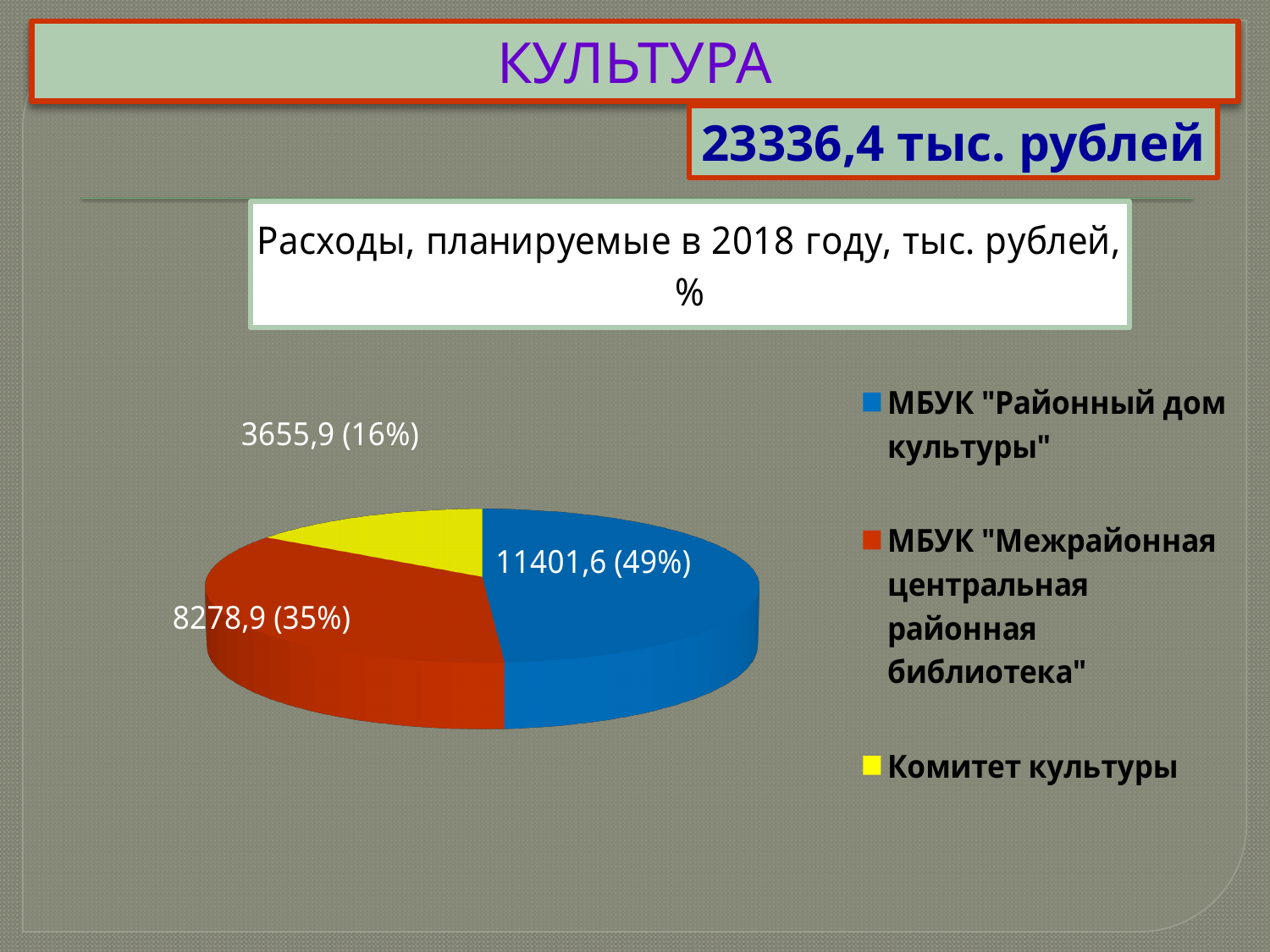
What is the value for Комитет культуры? 3655,9 What is the difference between the value for МБУК "Районный дом культуры" and the value for МБУК "Межрайонная центральная районная библиотека"? 3122,7 What share of the pie does Комитет культуры represent? 16% What is the value for МБУК "Районный дом культуры"? 11401,6 What is the title of the chart? Расходы, планируемые в 2018 году, тыс. рублей, % How many categories does the pie chart have? 3 What share of the pie does МБУК "Районный дом культуры" represent? 49% What kind of chart is shown on the slide? pie chart Which category has the largest slice of the pie? МБУК "Районный дом культуры" Which is larger: the value for МБУК "Межрайонная центральная районная библиотека" or the value for Комитет культуры? МБУК "Межрайонная центральная районная библиотека" What is the value for МБУК "Межрайонная центральная районная библиотека"? 8278,9 Which category has the smallest slice of the pie? Комитет культуры